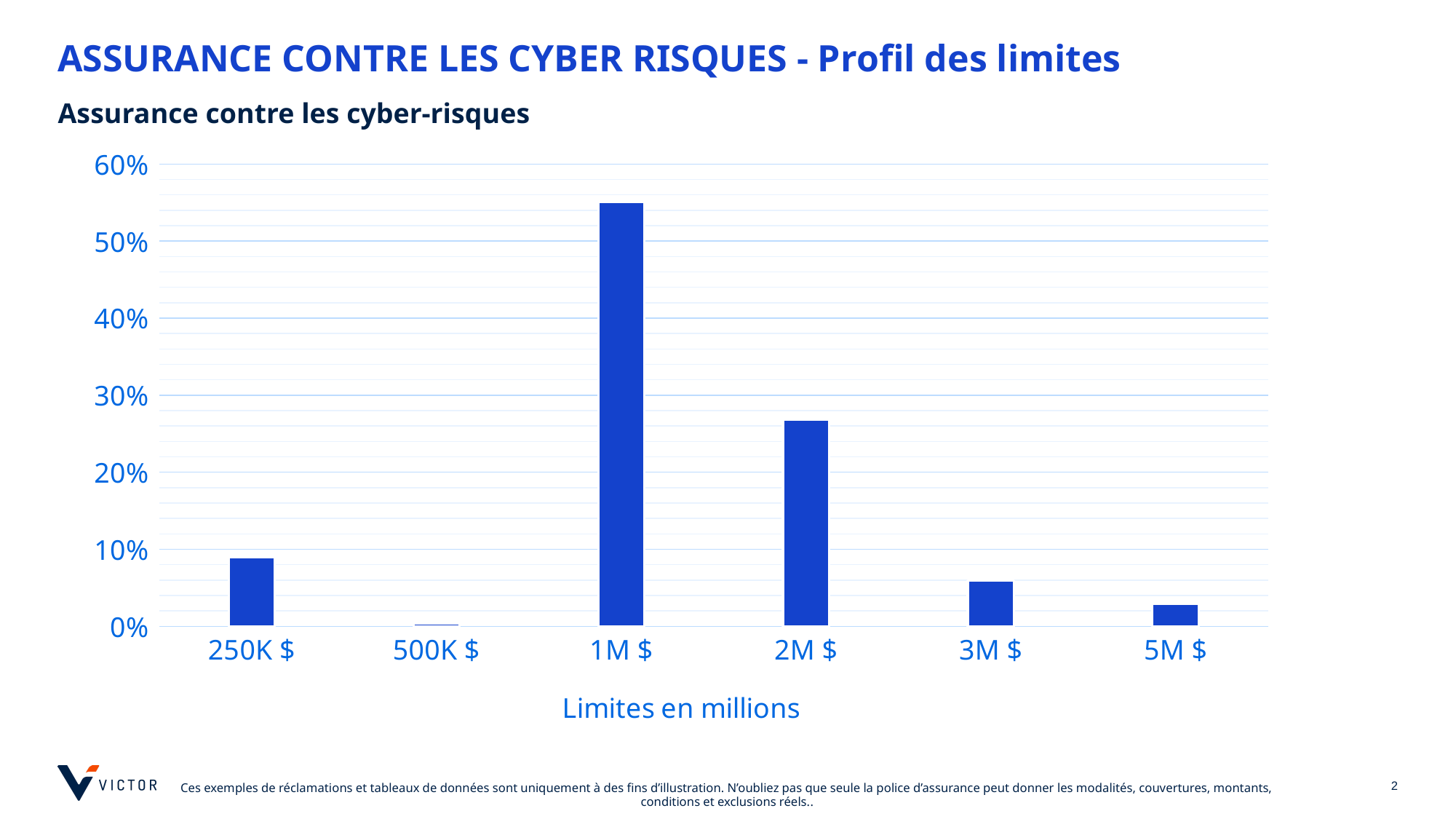
Is the value for 2M $ greater or less than 30%? less Which is larger, the value for 250K $ or the value for 5M $? 250K $ Is the value for 250K $ greater or less than 10%? less Is the value for 1M $ greater or less than 50%? greater What is the title of the x axis? Limites en millions Do the values rise or fall from 1M $ to 5M $ along the x axis? fall What kind of chart is shown on the slide? bar chart How many limit categories are shown on the x axis? 6 Which limit category has the highest value? 1M $ Which is larger, the value for 2M $ or the value for 3M $? 2M $ Which limit category has the lowest value? 500K $